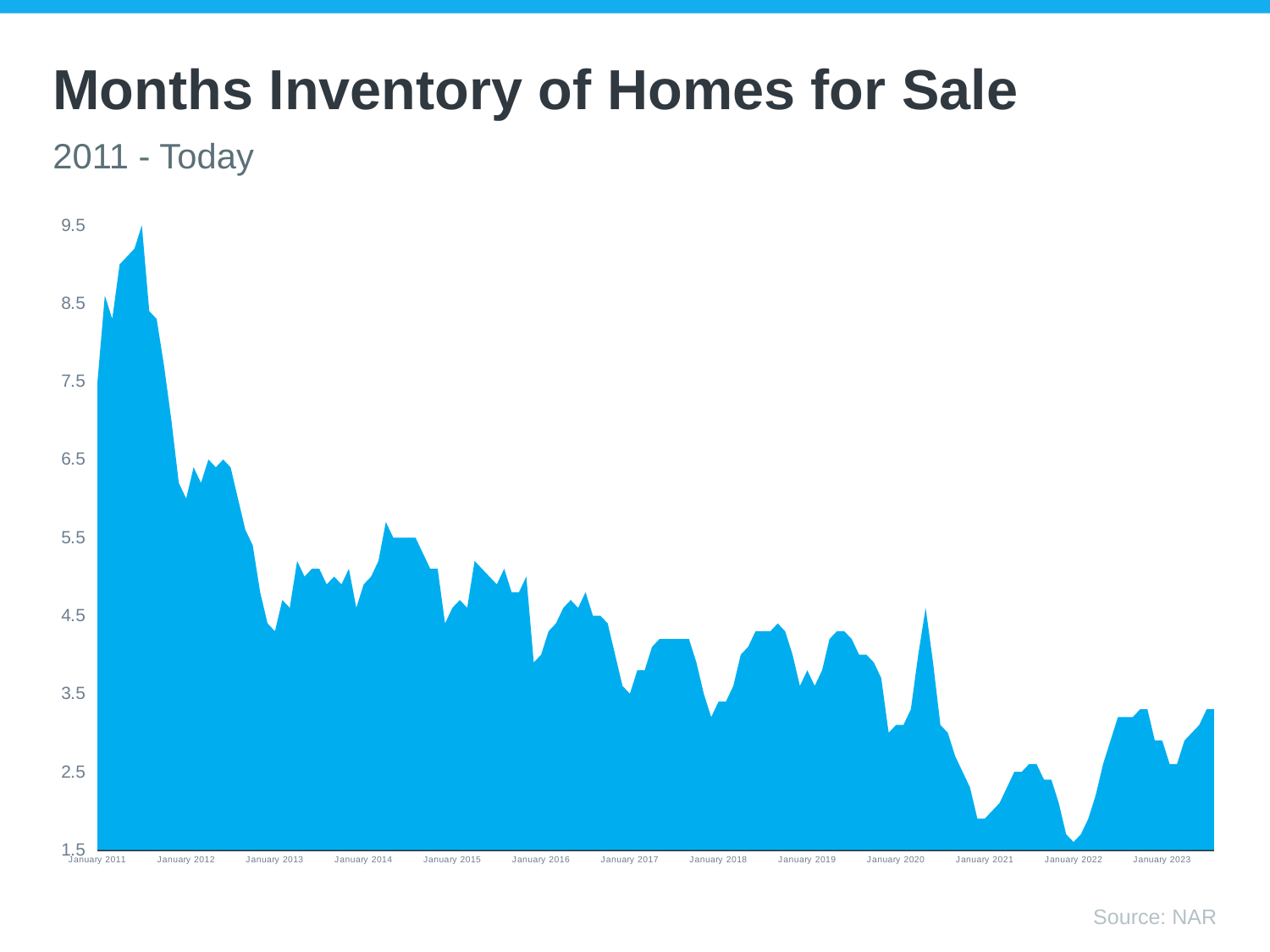
What source is cited for the chart data? NAR Is the value for January 2012 greater or less than 5.5? greater Is the value for January 2013 greater or less than 5.5? less Which is larger, the value for January 2012 or the value for January 2018? January 2012 Is the peak value in 2011 greater or less than 8.5? greater Overall, do the values rise or fall from January 2011 to January 2023? Fall What kind of chart is shown on the slide? Area chart In which year does the chart reach its highest value? 2011 In which year does the chart reach its lowest value? 2022 What is the title of the chart? Months Inventory of Homes for Sale